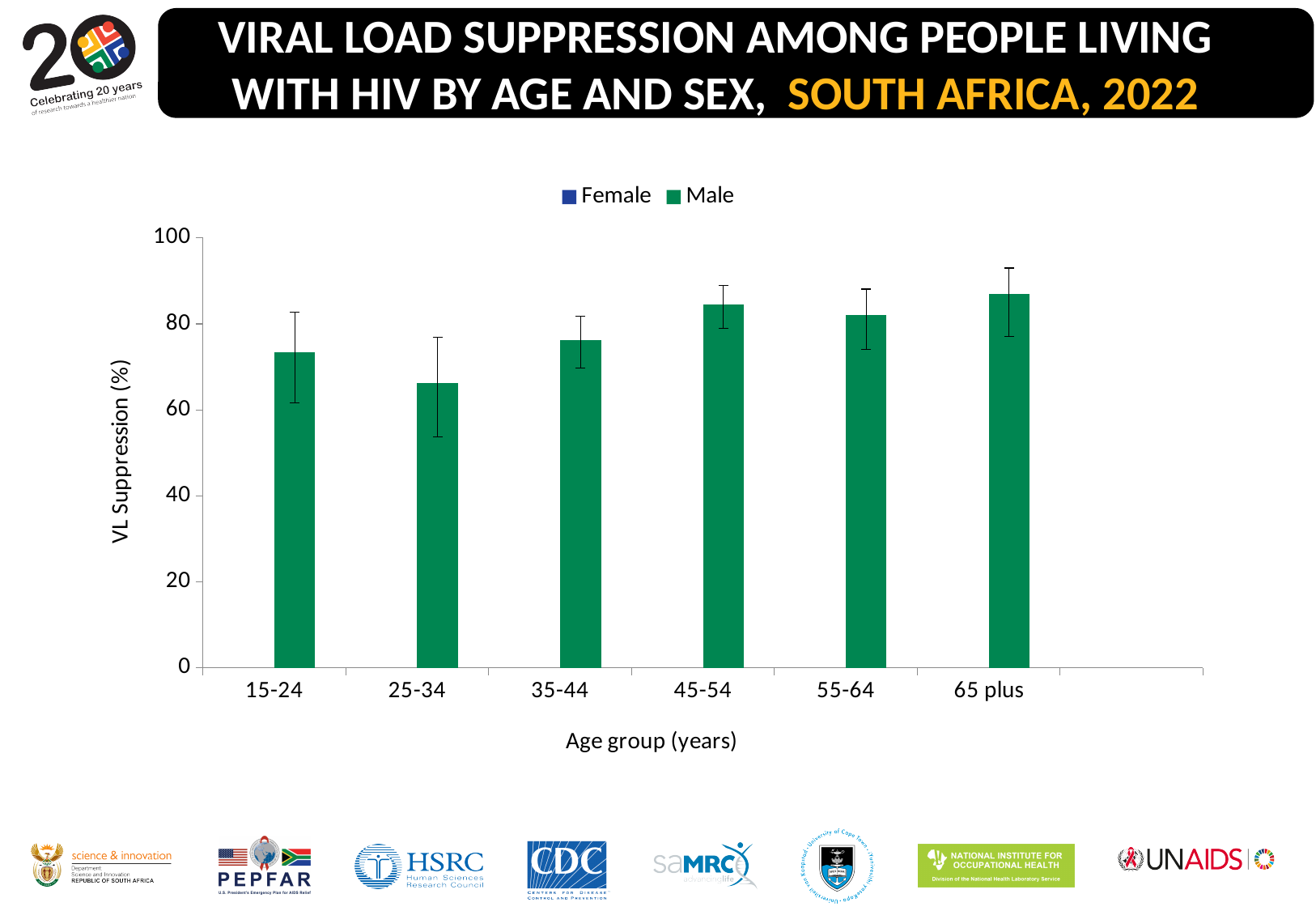
Which has the higher VL suppression: the 25-34 age group or the 35-44 age group? 35-44 What kind of chart is shown on the slide? bar chart How many series does the chart's legend list? 2 Is the VL suppression value for the 15-24 age group greater or less than 60? greater Is the VL suppression value for the 65 plus age group greater or less than 80? greater Is the VL suppression value for the 45-54 age group greater or less than 80? greater How many age groups are shown on the x axis of the chart? 6 Which age group has the lowest VL suppression among the plotted bars? 25-34 Which has the higher VL suppression: the 25-34 age group or the 45-54 age group? 45-54 What colour are the Male bars in the chart? green What is the label of the y axis of the chart? VL Suppression (%)